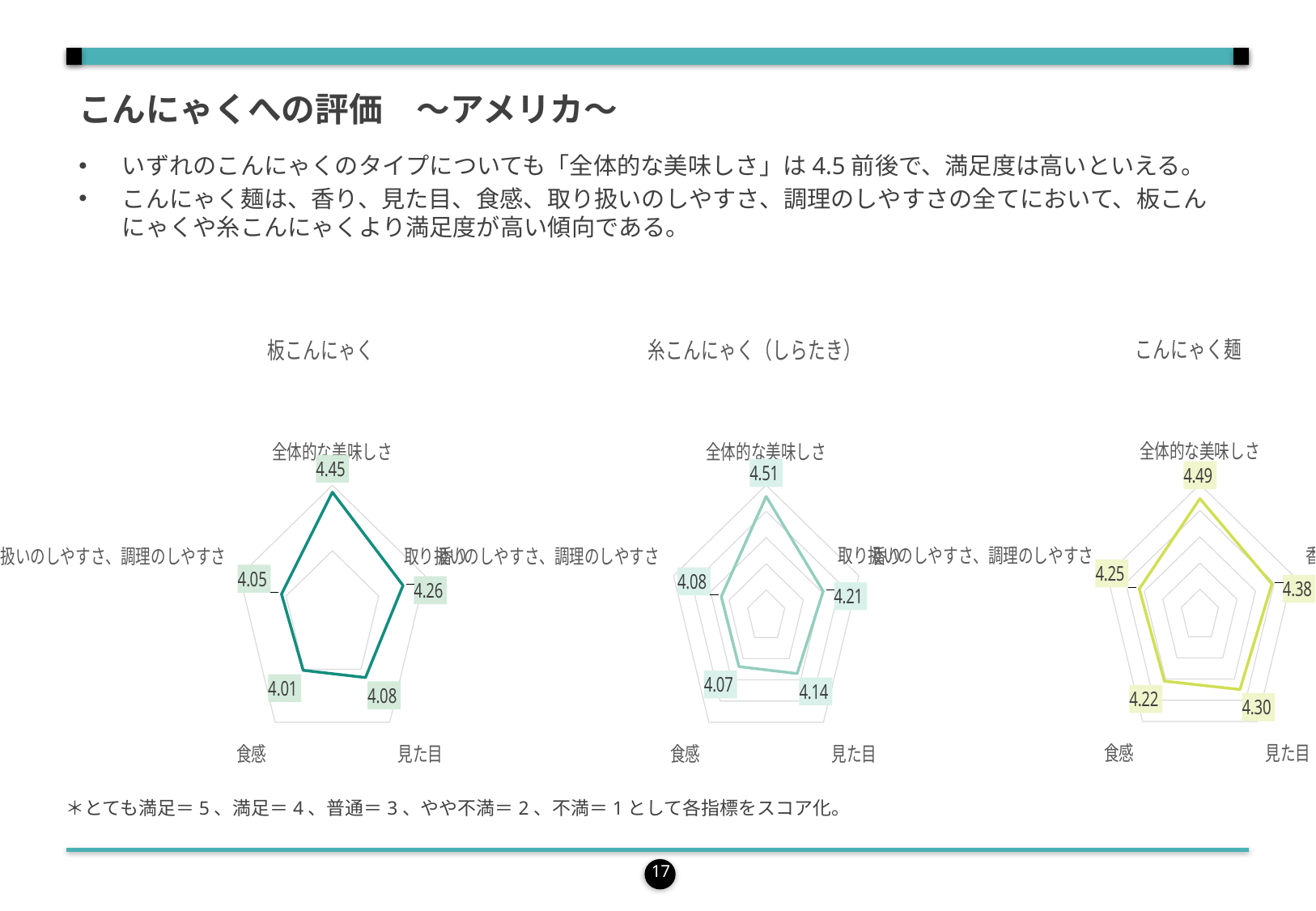
What type of chart is used on this slide? Radar chart In the 板こんにゃく chart, which item has the lowest score? 食感 In the 糸こんにゃく（しらたき） chart, what is the value for 全体的な美味しさ? 4.51 In the こんにゃく麺 chart, what is the difference between 全体的な美味しさ and 食感? 0.27 Which has the higher 食感 score, 板こんにゃく or こんにゃく麺? こんにゃく麺 In the こんにゃく麺 chart, what is the value for 見た目? 4.30 In the 糸こんにゃく（しらたき） chart, which item has the lowest score? 食感 In the こんにゃく麺 chart, what is the value for 食感? 4.22 In the 板こんにゃく chart, what is the value for 全体的な美味しさ? 4.45 In the 糸こんにゃく（しらたき） chart, what is the difference between 全体的な美味しさ and 見た目? 0.37 In the 板こんにゃく chart, which item has the highest score? 全体的な美味しさ How many evaluation items (axes) does each radar chart have? 5